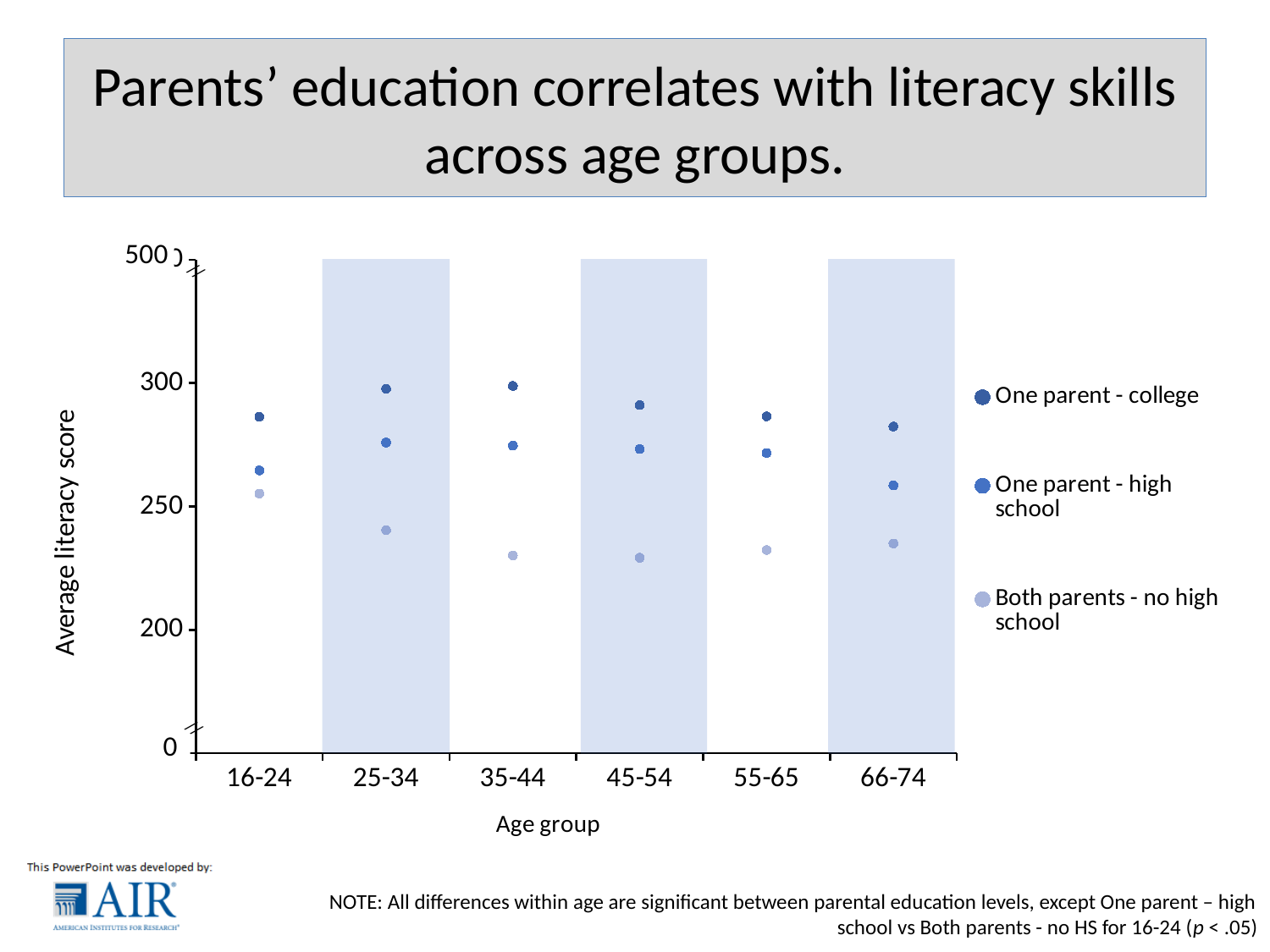
How many series does the legend list? 3 What is the label of the y axis? Average literacy score Do the values for Both parents - no high school rise or fall from the 16-24 age group to the 35-44 age group? fall Which age group has the highest value for the Both parents - no high school series? 16-24 What kind of chart is shown on the slide? Scatter chart Is the value for One parent - college in the 16-24 age group greater or less than 300? less How many age groups are shown on the x axis? 6 Is the value for One parent - high school in the 16-24 age group greater or less than 250? greater Is the value for Both parents - no high school in the 35-44 age group greater or less than 250? less Which age group has the lowest value for the One parent - high school series? 66-74 In the 45-54 age group, which series has the larger value: One parent - college or One parent - high school? One parent - college